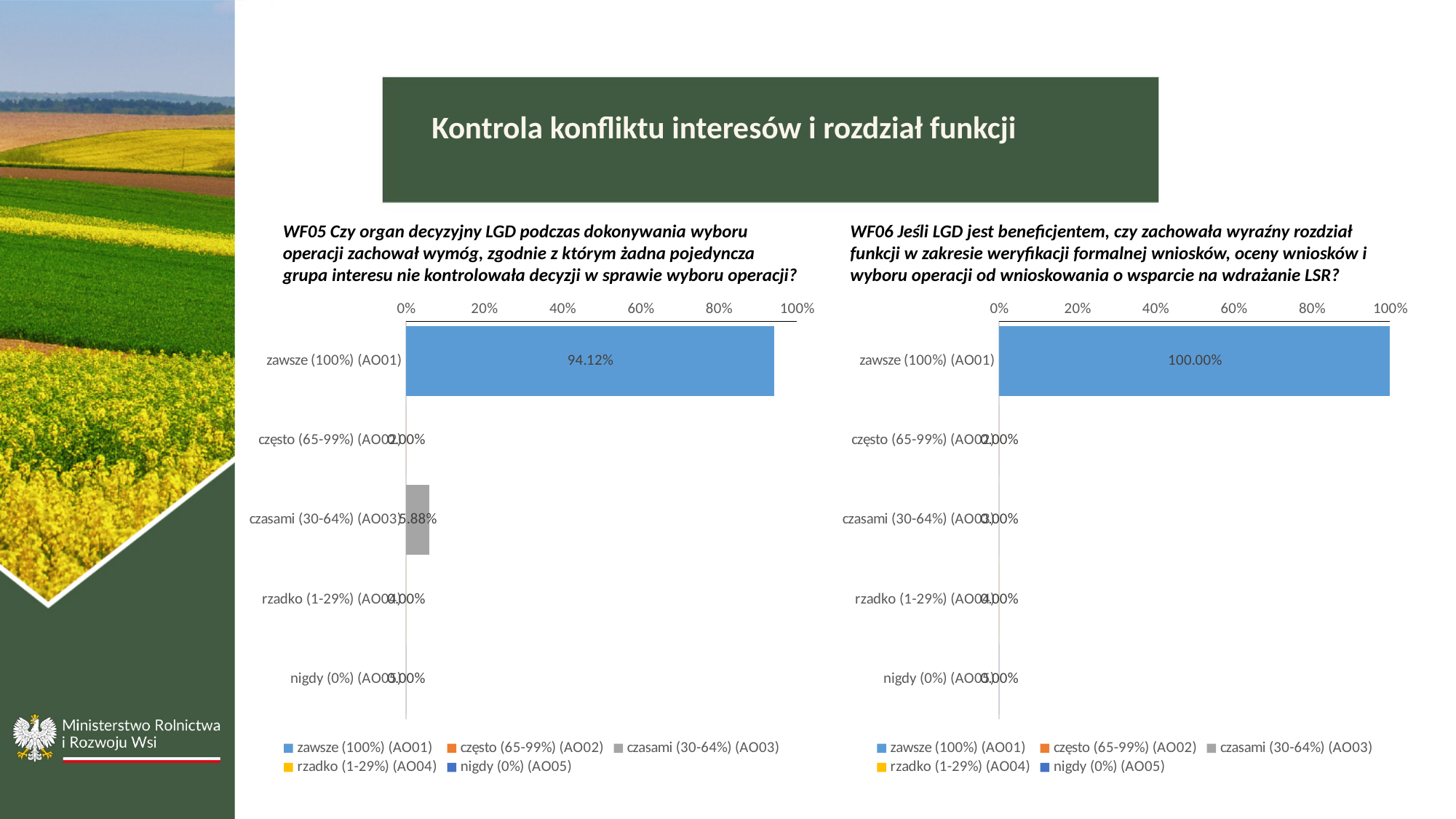
How many entries does the legend of the WF05 chart on the left list? 5 In the WF05 chart on the left, is the value for "zawsze (100%) (AO01)" greater or less than 80%? greater In the WF05 chart on the left, which category has the highest value? zawsze (100%) (AO01) In the WF06 chart on the right, what is the value for "zawsze (100%) (AO01)"? 100.00% In the WF05 chart on the left, what is the value for "czasami (30-64%) (AO03)"? 5.88% What kind of chart is the WF06 chart on the right? bar chart In the WF05 chart on the left, what is the difference between the values for "zawsze (100%) (AO01)" and "czasami (30-64%) (AO03)"? 88.24% In the WF05 chart on the left, which is larger: the value for "zawsze (100%) (AO01)" or for "czasami (30-64%) (AO03)"? zawsze (100%) (AO01) In the WF05 chart on the left, what colour is the bar for "czasami (30-64%) (AO03)"? grey How many categories are shown in the WF06 chart on the right? 5 In the WF05 chart on the left, what is the value for "zawsze (100%) (AO01)"? 94.12% In the WF06 chart on the right, what is the value for "czasami (30-64%) (AO03)"? 0.00%